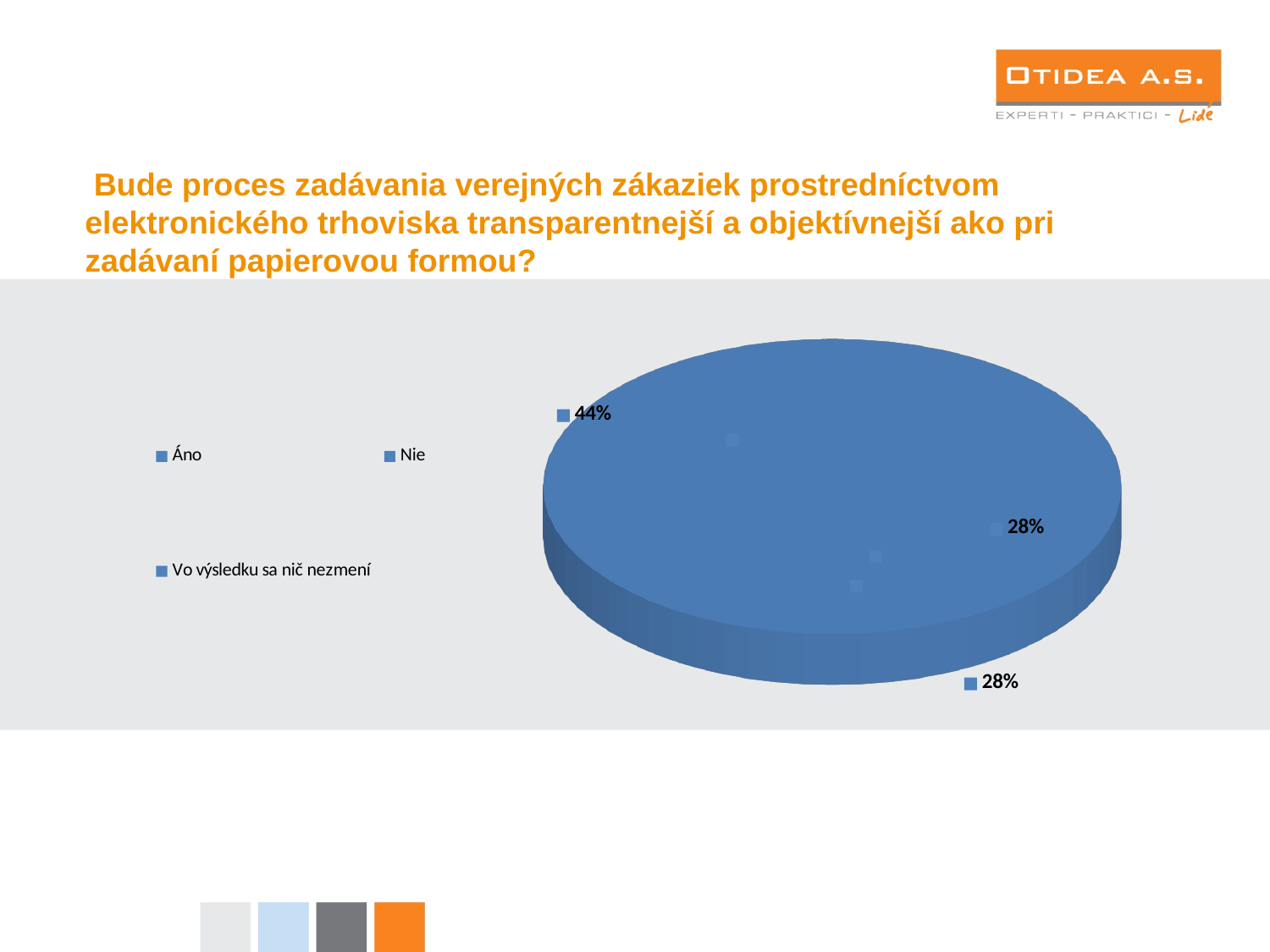
What is the smallest percentage shown on the pie chart? 28% How many data labels are shown on the pie chart? 3 What kind of chart is shown on the slide? pie chart What do the three percentage labels on the pie chart add up to? 100% What is the difference in percentage points between the largest slice (44%) and one of the 28% slices? 16 percentage points Is the largest slice of the pie chart greater or less than 50%? less What is the largest percentage shown on the pie chart? 44% How many categories does the legend of the pie chart list? 3 Which legend entries are listed for the pie chart? Áno, Nie, Vo výsledku sa nič nezmení How many slices of the pie chart are labelled 28%? 2 What colour are the slices of the pie chart? blue